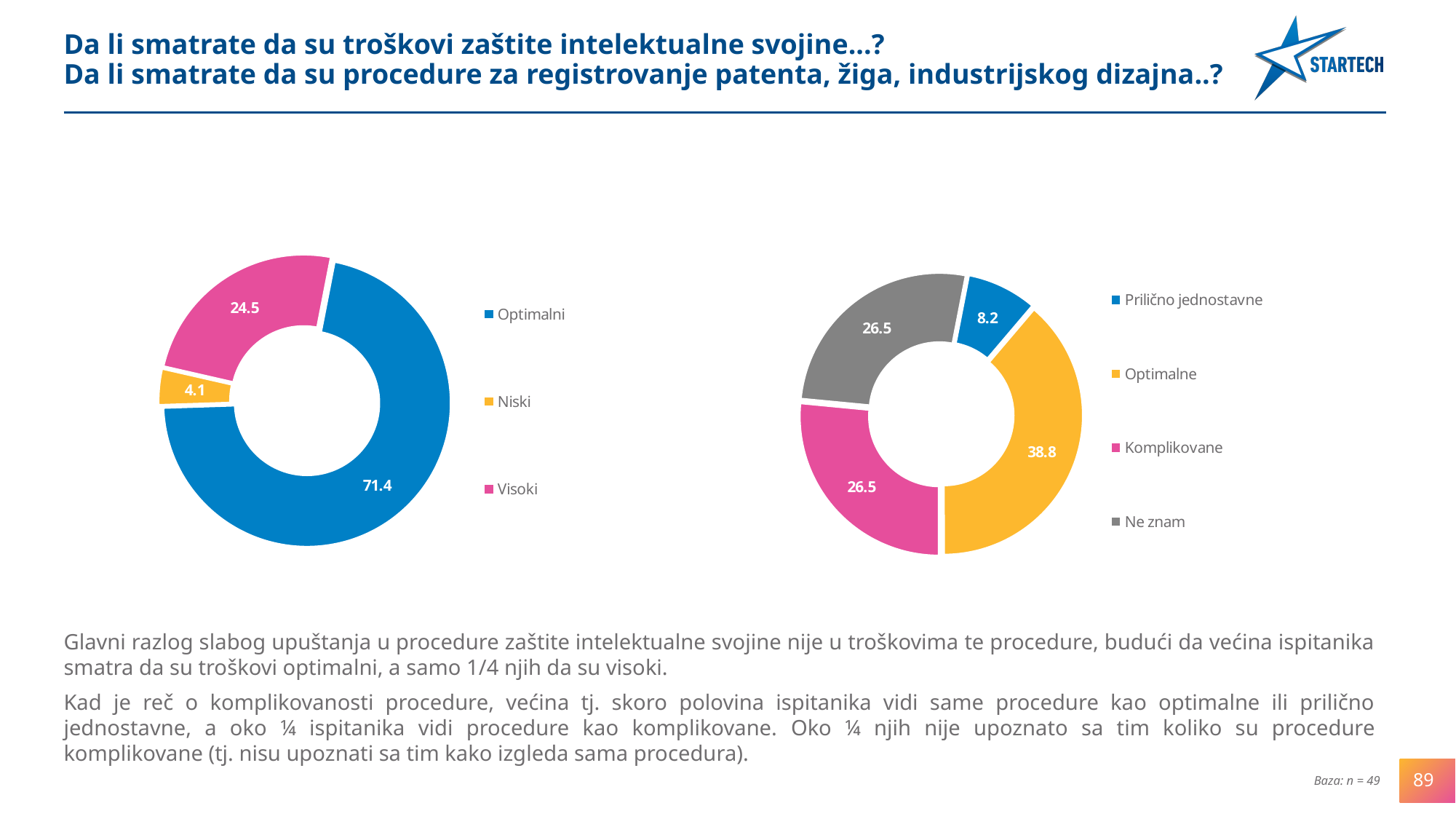
In the left chart, which category has the smallest slice? Niski In the left chart, what is the difference between the values for Optimalni and Visoki? 46.9 How many categories does the legend of the right chart list? 4 In the right chart, which category has the largest slice? Optimalne How many categories does the legend of the left chart list? 3 In the right chart, what colour is the Ne znam slice? Grey What kind of chart is the left chart? Doughnut (pie) chart In the right chart, which is larger: Komplikovane or Prilično jednostavne? Komplikovane In the left chart, what is the value for Optimalni? 71.4 In the right chart, what is the value for Optimalne? 38.8 In the right chart, what is the value for Prilično jednostavne? 8.2 In the left chart, what is the value for Niski? 4.1